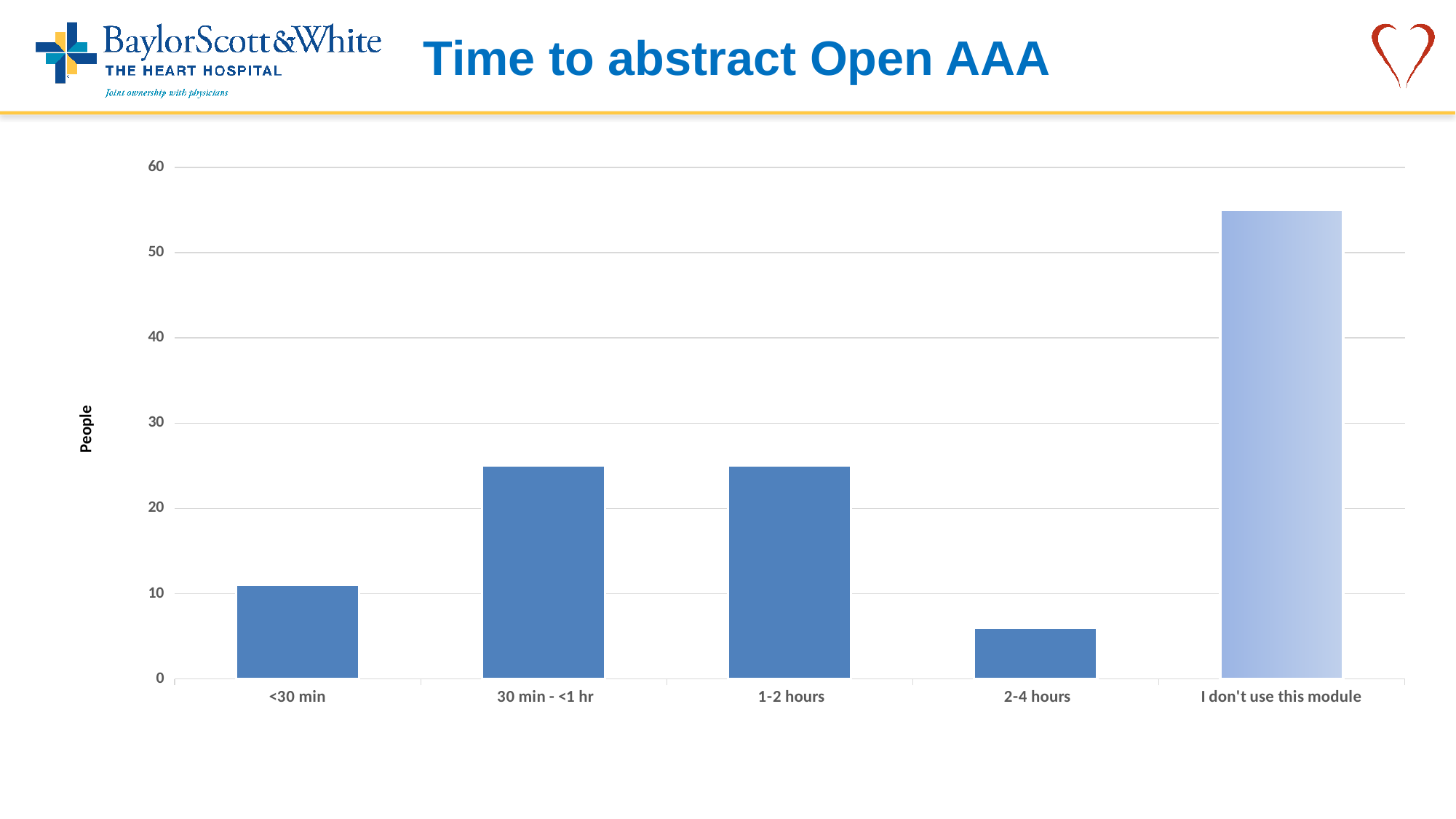
Which category has the highest value in the chart? I don't use this module Is the value for "<30 min" greater or less than 20? less What kind of chart is shown on the slide? bar chart Which has a larger value, "<30 min" or "30 min - <1 hr"? 30 min - <1 hr Which category has the lowest value in the chart? 2-4 hours What is the label on the vertical axis of the chart? People Is the value for "1-2 hours" greater or less than 30? less Which has a larger value, "<30 min" or "2-4 hours"? <30 min Is the value for "30 min - <1 hr" greater or less than 20? greater How many categories are shown on the x axis of the chart? 5